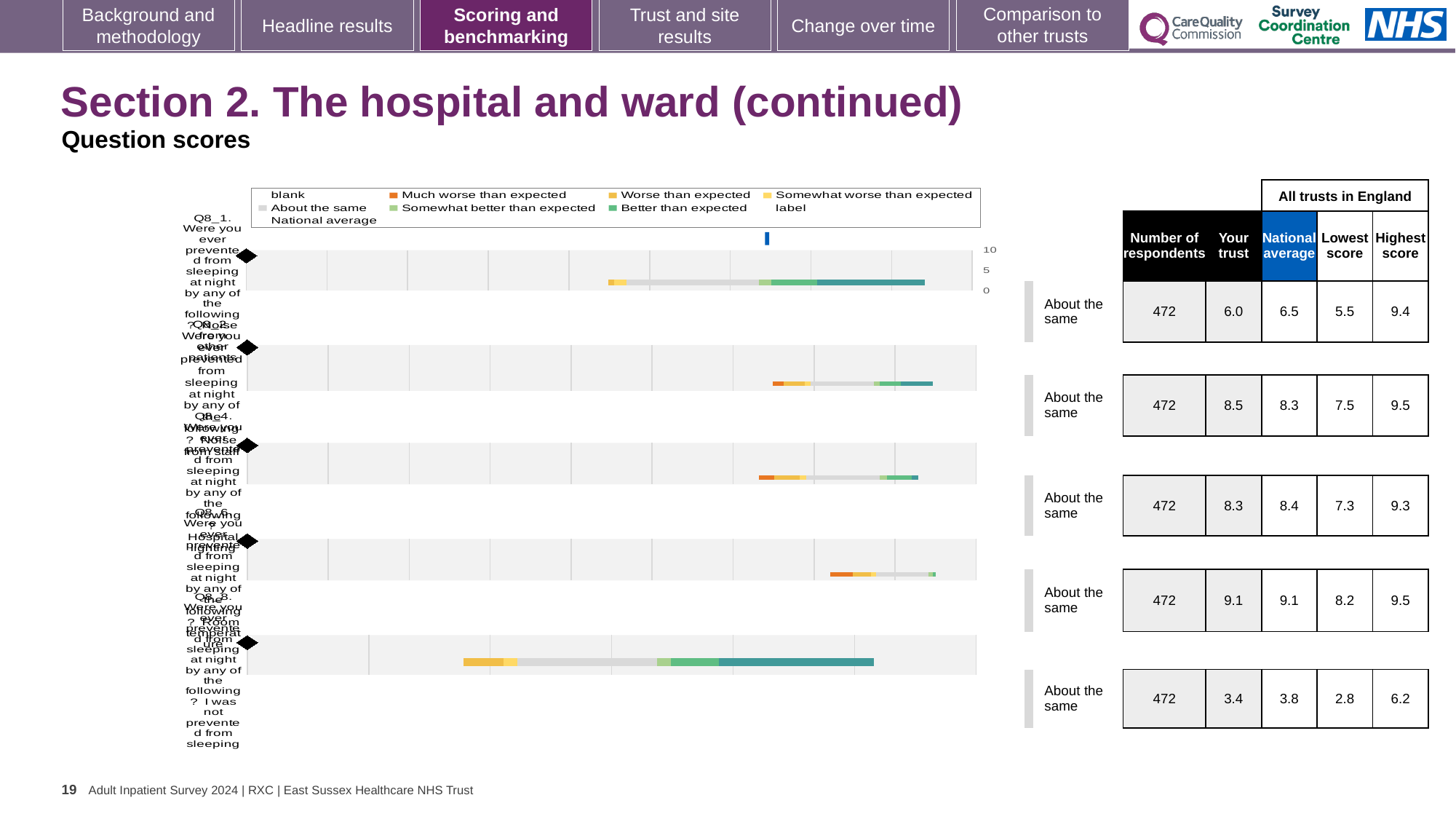
For the first row (Q8_1), what is the difference between the Highest score and the Lowest score in the table? 3.9 How many entries does the chart's legend list? 9 What kind of chart is shown on the slide? bar chart Which legend entry is shown in orange? Much worse than expected Which legend entry is shown in teal? Better than expected In the table beside the chart, what is the number of respondents for each question? 472 What benchmark label is shown next to each of the five question rows? About the same How many question rows (bars) are plotted in the chart? 5 For the first row (Q8_1), which is larger: the 'Your trust' score or the National average? National average In the table beside the chart, what is the 'Your trust' score for the last row (Q8_8)? 3.4 In the table beside the chart, what is the National average for the first row (Q8_1)? 6.5 In the table beside the chart, what is the 'Your trust' score for the first row (Q8_1)? 6.0